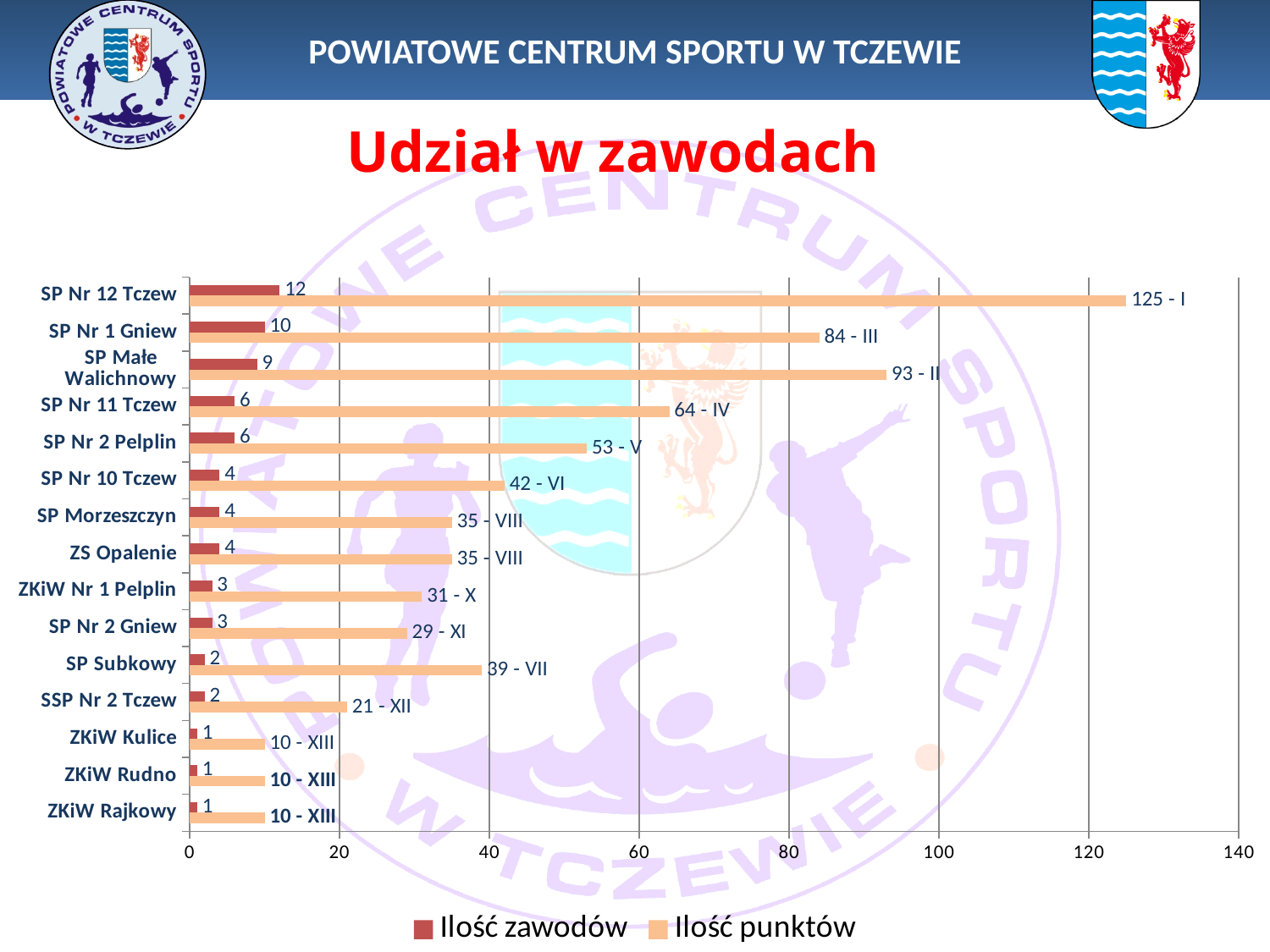
How many series does the legend list? 2 What is the title of the chart? Udział w zawodach What is the difference between the Ilość zawodów values of SP Nr 1 Gniew and SP Nr 10 Tczew? 6 How many schools (categories) are shown on the chart? 15 Which has a larger Ilość punktów value, SP Subkowy or SP Nr 2 Gniew? SP Subkowy What is the Ilość zawodów value for SP Nr 12 Tczew? 12 Which school has the highest Ilość punktów value? SP Nr 12 Tczew What data label is shown on the Ilość punktów bar for SP Małe Walichnowy? 93 - II Which school has the highest Ilość zawodów value? SP Nr 12 Tczew What type of chart is shown on the slide? bar chart What is the Ilość zawodów value for SP Nr 2 Pelplin? 6 What is the difference between the Ilość punktów values of SP Nr 12 Tczew (125) and SP Nr 1 Gniew (84)? 41